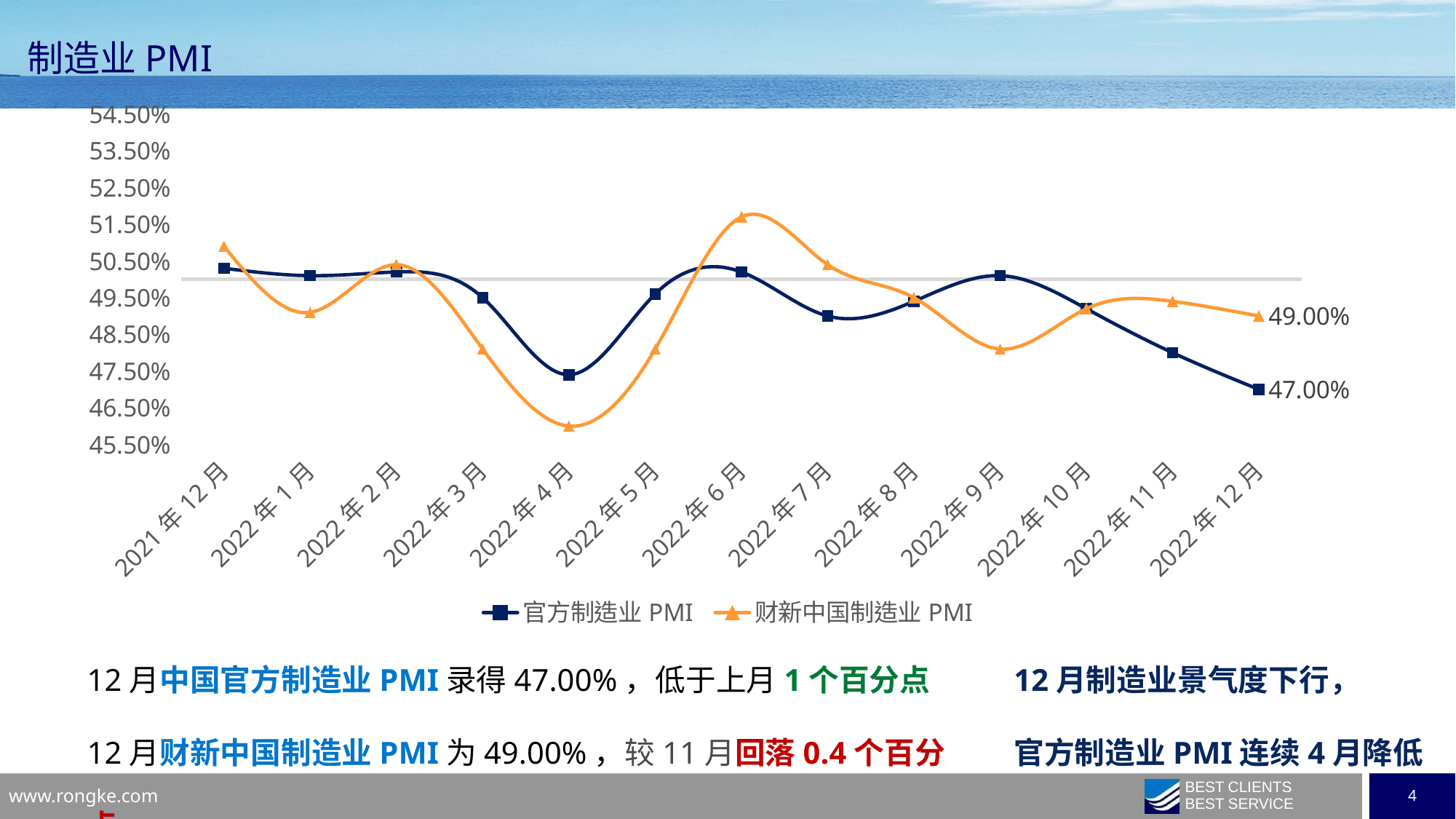
In 2022年4月, which series is higher, 官方制造业 PMI or 财新中国制造业 PMI? 官方制造业 PMI What is the difference between 财新中国制造业 PMI and 官方制造业 PMI in 2022年12月? 2.00% Is the value of 财新中国制造业 PMI for 2022年6月 greater or less than 50.50%? greater Is the value of 财新中国制造业 PMI for 2022年4月 greater or less than 46.50%? less What kind of chart is shown on the slide? line chart In which month does 财新中国制造业 PMI reach its lowest value? 2022年4月 In which month does 财新中国制造业 PMI reach its highest value? 2022年6月 How many months are plotted on the x axis? 13 What is the value of 财新中国制造业 PMI for 2022年12月? 49.00% How many series does the legend list? 2 In 2022年12月, which series is higher, 官方制造业 PMI or 财新中国制造业 PMI? 财新中国制造业 PMI What is the value of 官方制造业 PMI for 2022年12月? 47.00%